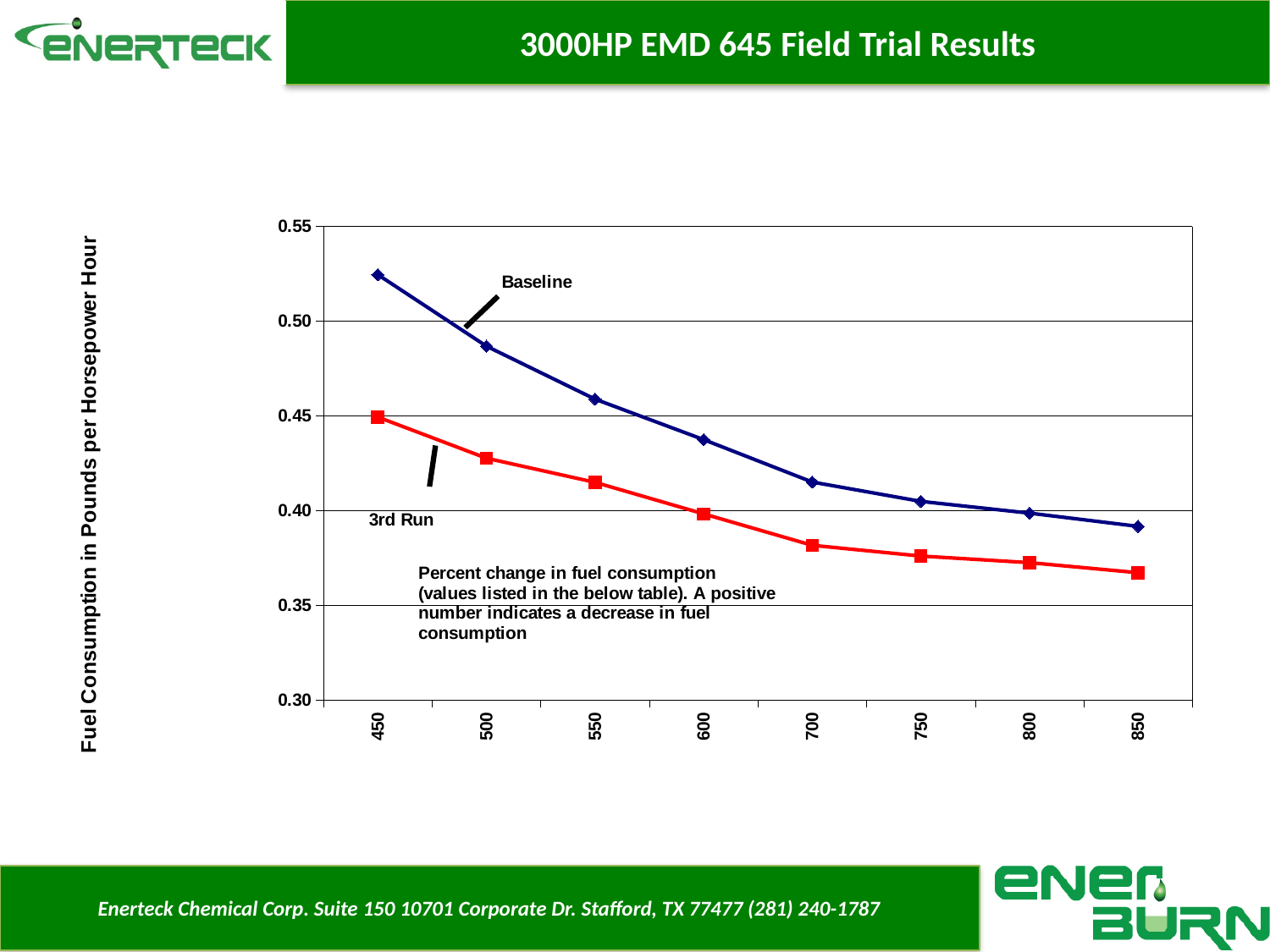
How many x-axis categories are shown on the chart? 8 Is the Baseline value at 850 greater or less than 0.40? less How many data series are plotted on the chart? 2 Is the Baseline value at 450 greater or less than 0.50? greater Do the values of the 3rd Run series rise or fall as the x-axis values increase? fall Is the 3rd Run value at 850 greater or less than 0.35? greater What are the names of the two lines plotted on the chart? Baseline and 3rd Run At 600, which series has the higher value, Baseline or 3rd Run? Baseline What kind of chart is shown on the slide? line chart Do the values of the Baseline series rise or fall as the x-axis values increase? fall What is the y-axis title of the chart? Fuel Consumption in Pounds per Horsepower Hour